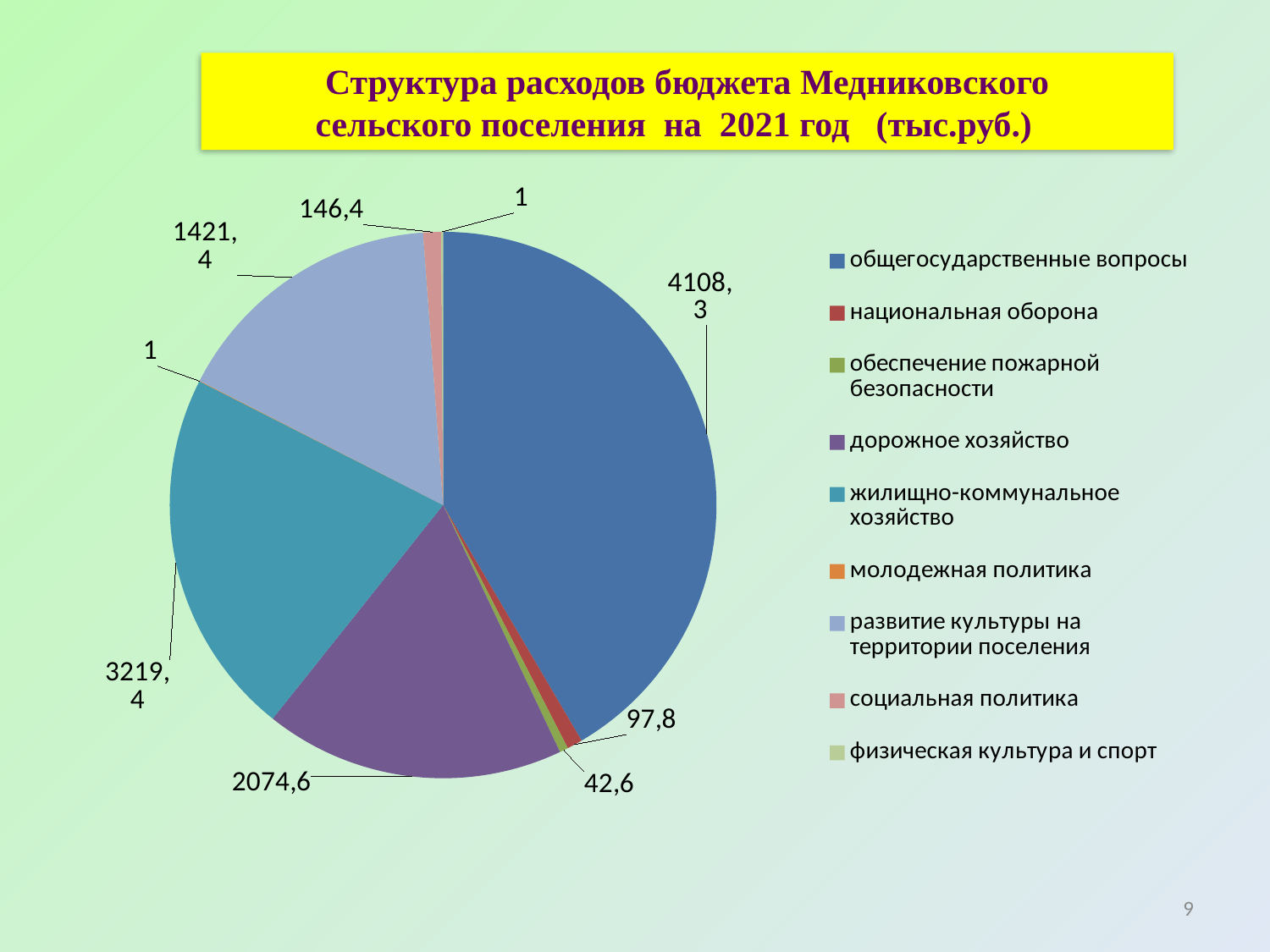
What is the value for развитие культуры на территории поселения? 1421,4 What is the value for общегосударственные вопросы? 4108,3 What is the value for социальная политика? 146,4 What is the value for национальная оборона? 97,8 What type of chart is shown on the slide? Pie chart What is the value for дорожное хозяйство? 2074,6 What is the value for жилищно-коммунальное хозяйство? 3219,4 Which category has the largest slice of the pie? общегосударственные вопросы What is the title of the chart? Структура расходов бюджета Медниковского сельского поселения на 2021 год (тыс.руб.) How many categories does the legend list? 9 Which is larger, the value for дорожное хозяйство or the value for развитие культуры на территории поселения? дорожное хозяйство What is the difference between the values for общегосударственные вопросы and жилищно-коммунальное хозяйство? 888,9